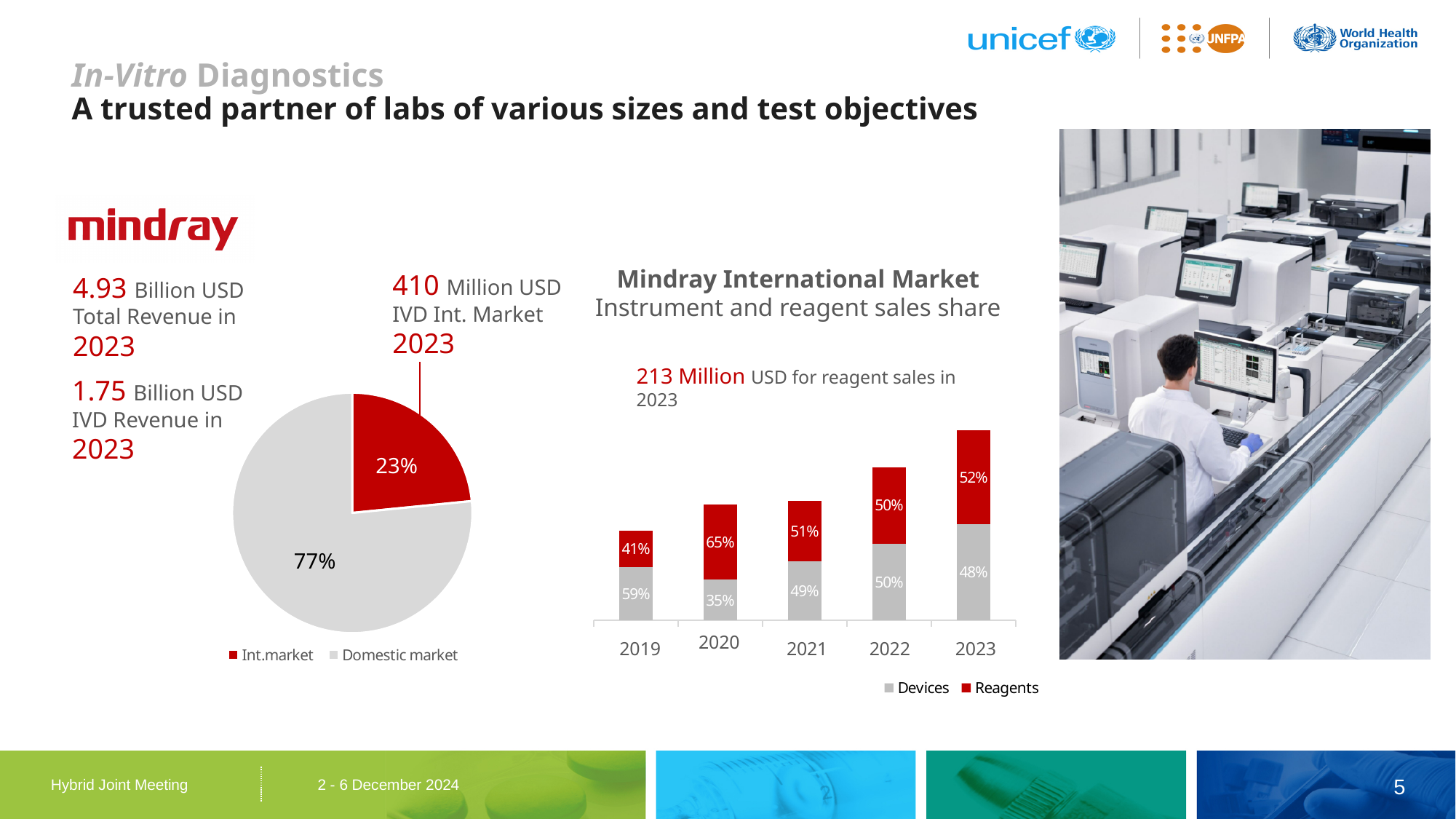
In the 'Mindray International Market' chart, which year has the lowest Devices share? 2020 In the pie chart, what is the difference between the Domestic market share and the Int.market share? 54% How many series does the legend of the 'Mindray International Market' chart list? 2 In the 'Mindray International Market' chart, how many years are shown on the x axis? 5 In the 'Mindray International Market' chart, which year has the highest Reagents share? 2020 In the 'Mindray International Market' chart, what is the Reagents value for 2020? 65% What kind of chart is the 'Mindray International Market' chart? Stacked bar chart In the pie chart, what share does the Domestic market slice represent? 77% In the pie chart, which slice is larger, Int.market or Domestic market? Domestic market In the 'Mindray International Market' chart, what is the difference between the Devices and Reagents values in 2019? 18% In the 'Mindray International Market' chart, what is the Devices value for 2023? 48% In the pie chart, what share does the Int.market slice represent? 23%